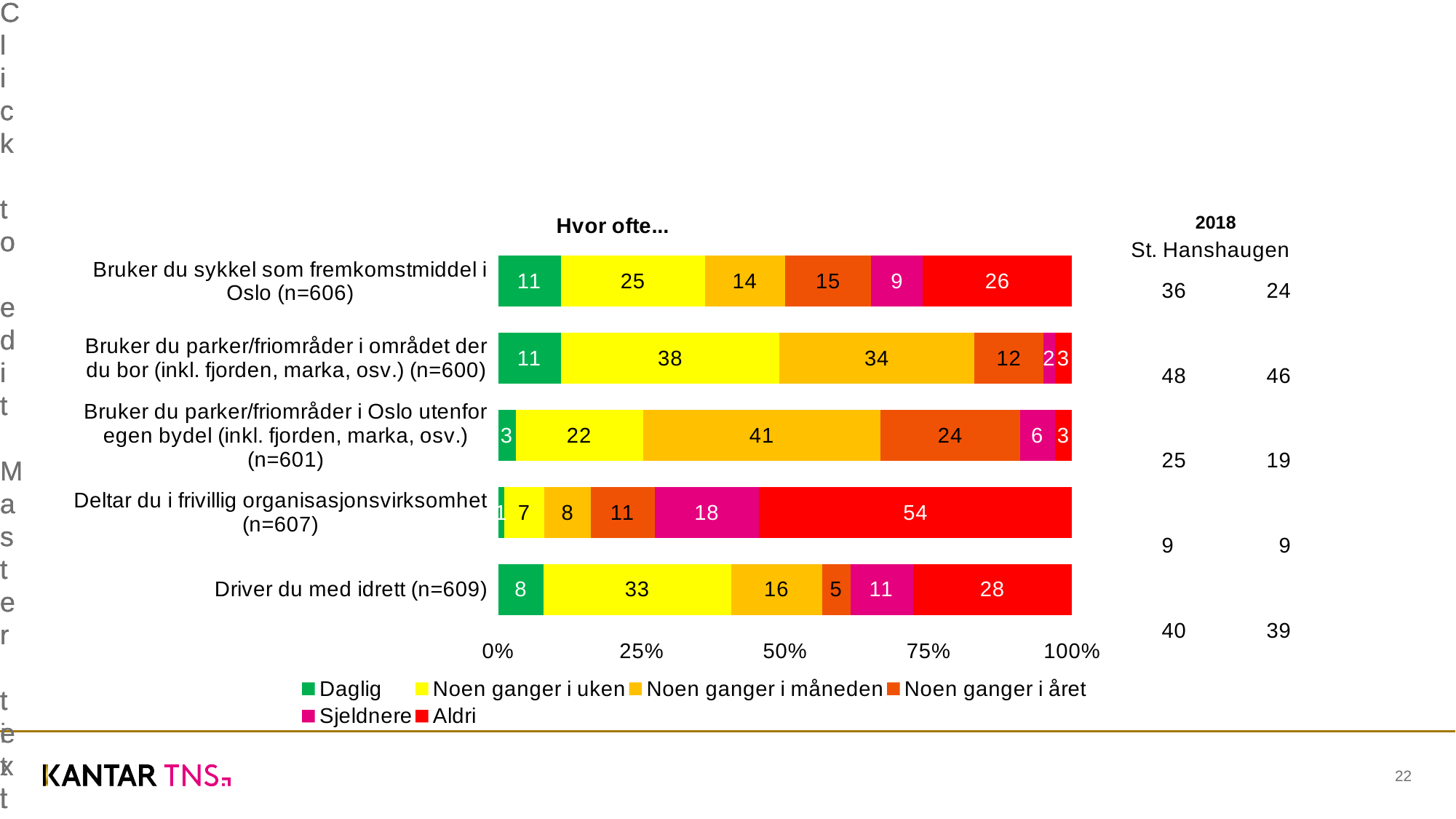
How many categories (bars) are shown in the chart? 5 Which has the larger "Noen ganger i måneden" value: "Bruker du parker/friområder i Oslo utenfor egen bydel" or "Bruker du parker/friområder i området der du bor"? Bruker du parker/friområder i Oslo utenfor egen bydel (inkl. fjorden, marka, osv.) (n=601) What is the value for "Aldri" in the bar "Deltar du i frivillig organisasjonsvirksomhet (n=607)"? 54 What is the title of the chart? Hvor ofte... What is the value for "Daglig" in the bar "Driver du med idrett (n=609)"? 8 Which category has the lowest value for "Daglig"? Deltar du i frivillig organisasjonsvirksomhet (n=607) What is the value for "Noen ganger i uken" in the bar "Bruker du parker/friområder i området der du bor (inkl. fjorden, marka, osv.) (n=600)"? 38 What is the difference between the "Aldri" values for "Driver du med idrett (n=609)" and "Bruker du sykkel som fremkomstmiddel i Oslo (n=606)"? 2 How many series does the legend list? 6 Which category has the highest value for "Noen ganger i måneden"? Bruker du parker/friområder i Oslo utenfor egen bydel (inkl. fjorden, marka, osv.) (n=601) What kind of chart is shown on the slide? Stacked bar chart Which category has the highest value for "Aldri"? Deltar du i frivillig organisasjonsvirksomhet (n=607)